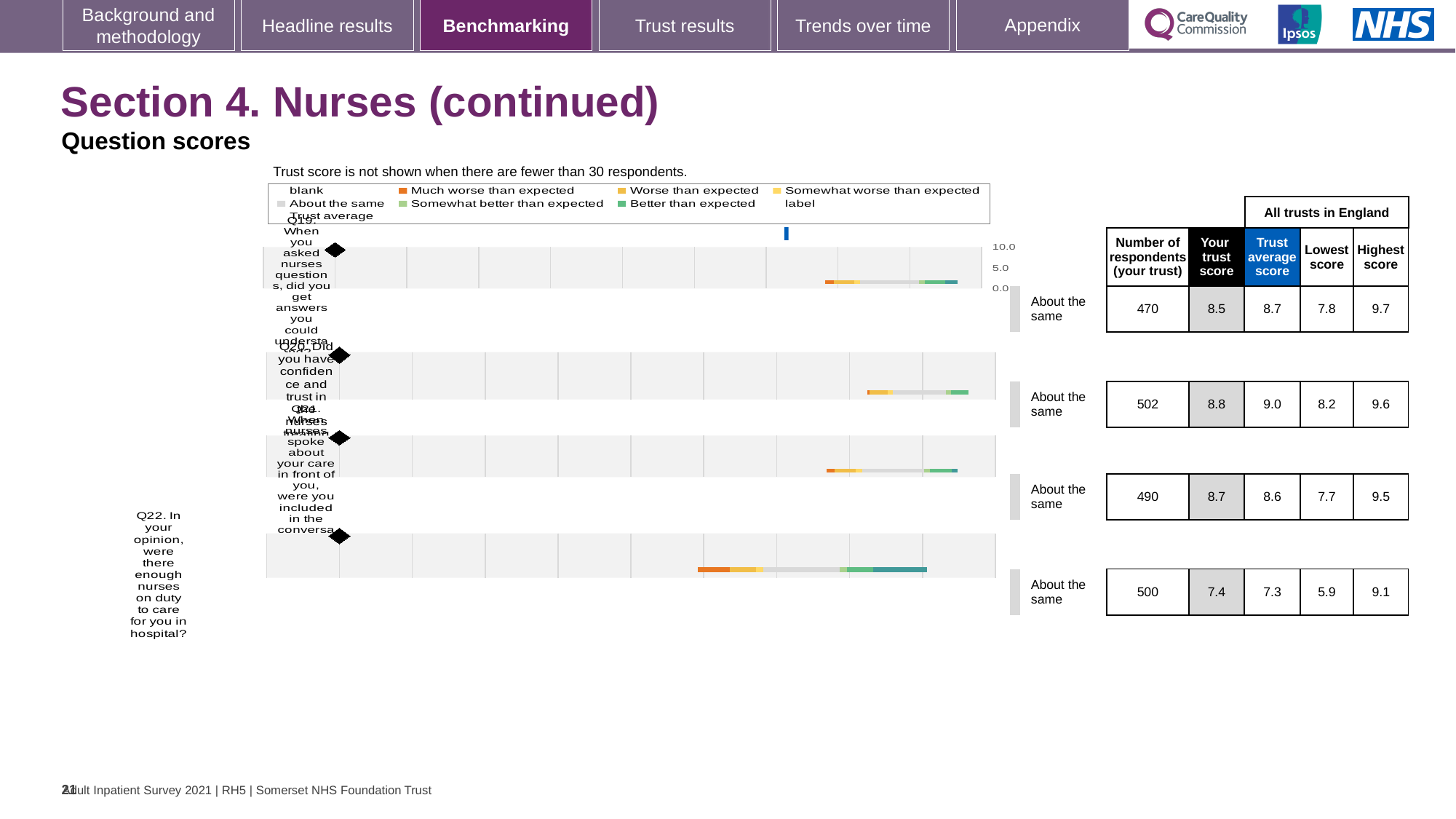
What type of chart is used to show the question scores? bar chart What is the trust average score for Q20 (did you have confidence and trust in the nurses treating you)? 9.0 How many questions are plotted on the chart? 4 What is the difference between your trust score and the trust average score for Q22? 0.1 What benchmark category is shown for all four questions? About the same Which question has the highest 'Your trust score'? Q20 What is the highest score across all trusts in England for Q19? 9.7 What is the lowest score across all trusts in England for Q22? 5.9 Which question has the lowest 'Your trust score'? Q22 For Q21, is your trust score higher or lower than the trust average score? higher What is your trust score for Q19 (when you asked nurses questions, did you get answers you could understand)? 8.5 How many respondents from your trust answered Q22 (were there enough nurses on duty to care for you in hospital)? 500